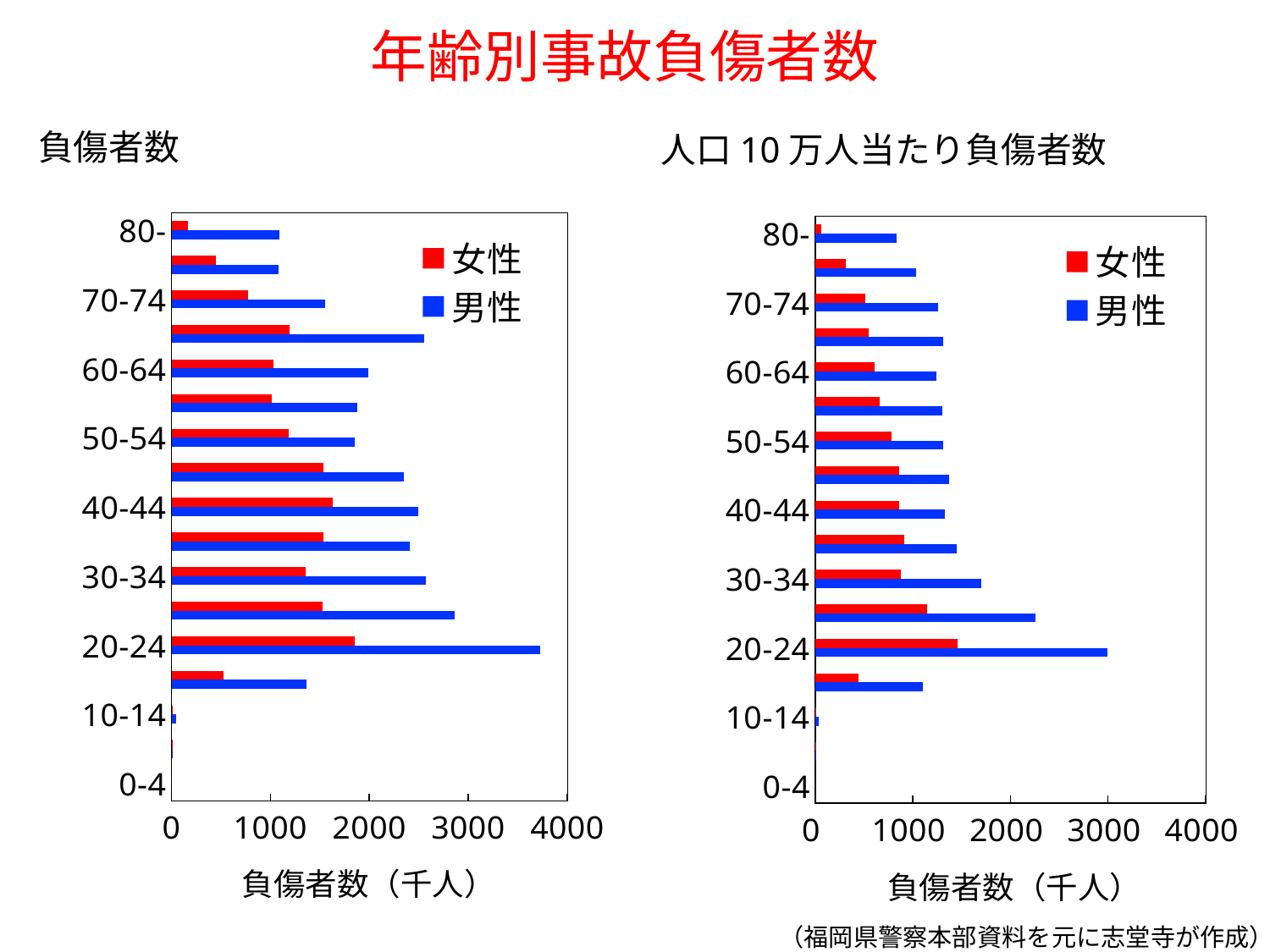
In the right chart (人口10万人当たり負傷者数), which age group has the highest value for 女性? 20-24 What is the x-axis title of the right chart (人口10万人当たり負傷者数)? 負傷者数（千人） In the left chart (負傷者数), is the value for 男性 in the 20-24 age group greater or less than 3000? greater In the left chart (負傷者数), which age group has the highest value for 男性? 20-24 How many series does the legend of the right chart (人口10万人当たり負傷者数) list? 2 What are the two legend entries in the left chart (負傷者数)? 女性 and 男性 In the left chart (負傷者数), is the value for 女性 in the 20-24 age group greater or less than 1000? greater In the left chart (負傷者数), which is larger for the 20-24 age group, 女性 or 男性? 男性 What kind of chart is the left chart titled 負傷者数? bar chart In the right chart (人口10万人当たり負傷者数), is the value for 女性 in the 70-74 age group greater or less than 1000? less In the right chart (人口10万人当たり負傷者数), which is larger for the 80- age group, 女性 or 男性? 男性